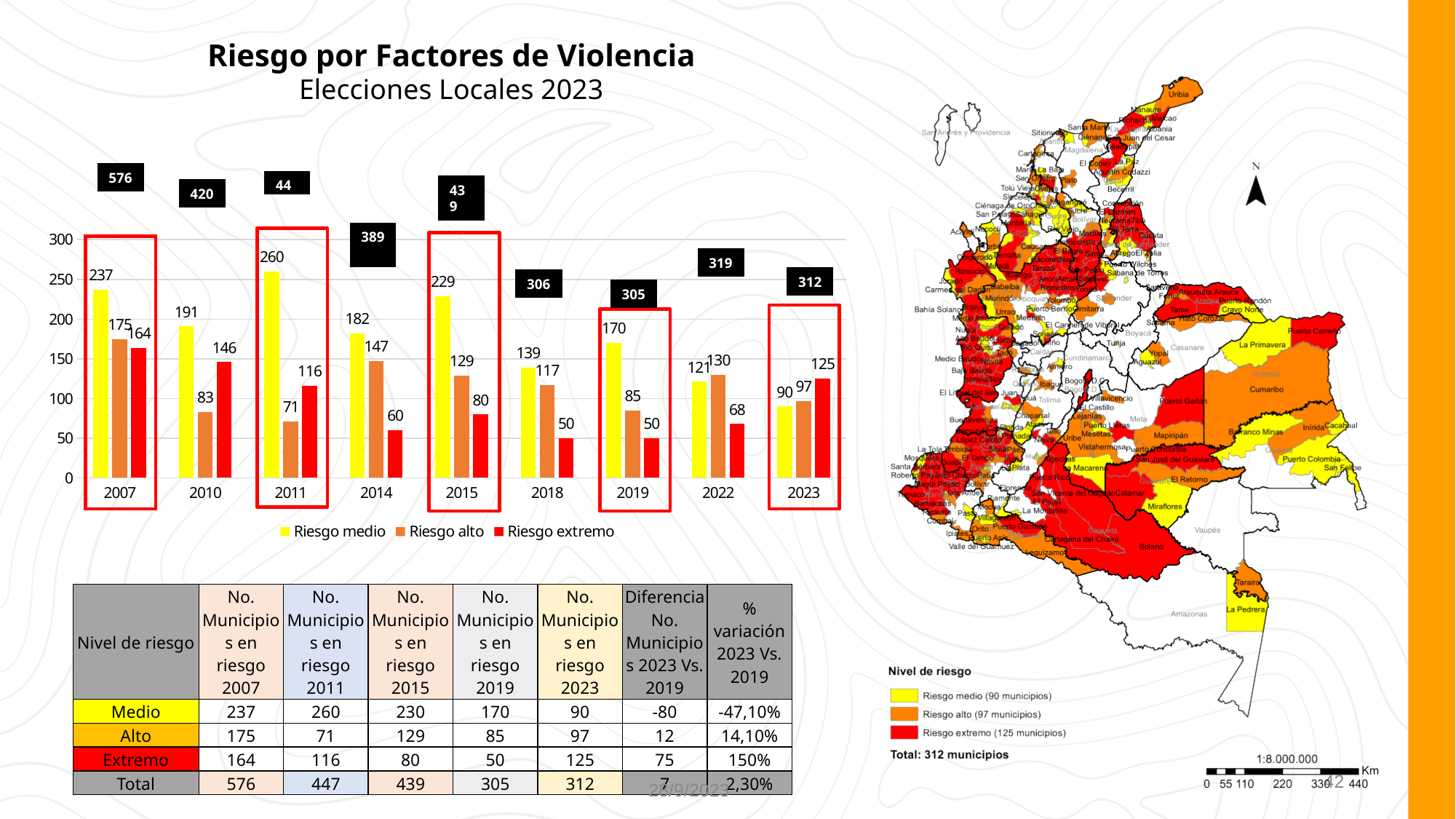
In the bar chart, does the Riesgo medio value rise or fall from 2015 to 2023? Fall In the bar chart, what is the value of Riesgo medio for 2007? 237 What kind of chart is shown on the left of the slide? Bar chart In the bar chart, which year has the lowest Riesgo medio value? 2023 In the bar chart, what is the difference between the Riesgo medio values for 2019 and 2023? 80 In the bar chart, for 2022, which is larger: Riesgo medio or Riesgo alto? Riesgo alto In the bar chart, what is the value of Riesgo alto for 2014? 147 How many series does the legend of the bar chart list? 3 How many years are shown on the x axis of the bar chart? 9 In the bar chart, what is the total of the three risk values for 2007? 576 In the bar chart, what is the value of Riesgo extremo for 2023? 125 In the bar chart, which year has the highest Riesgo medio value? 2011